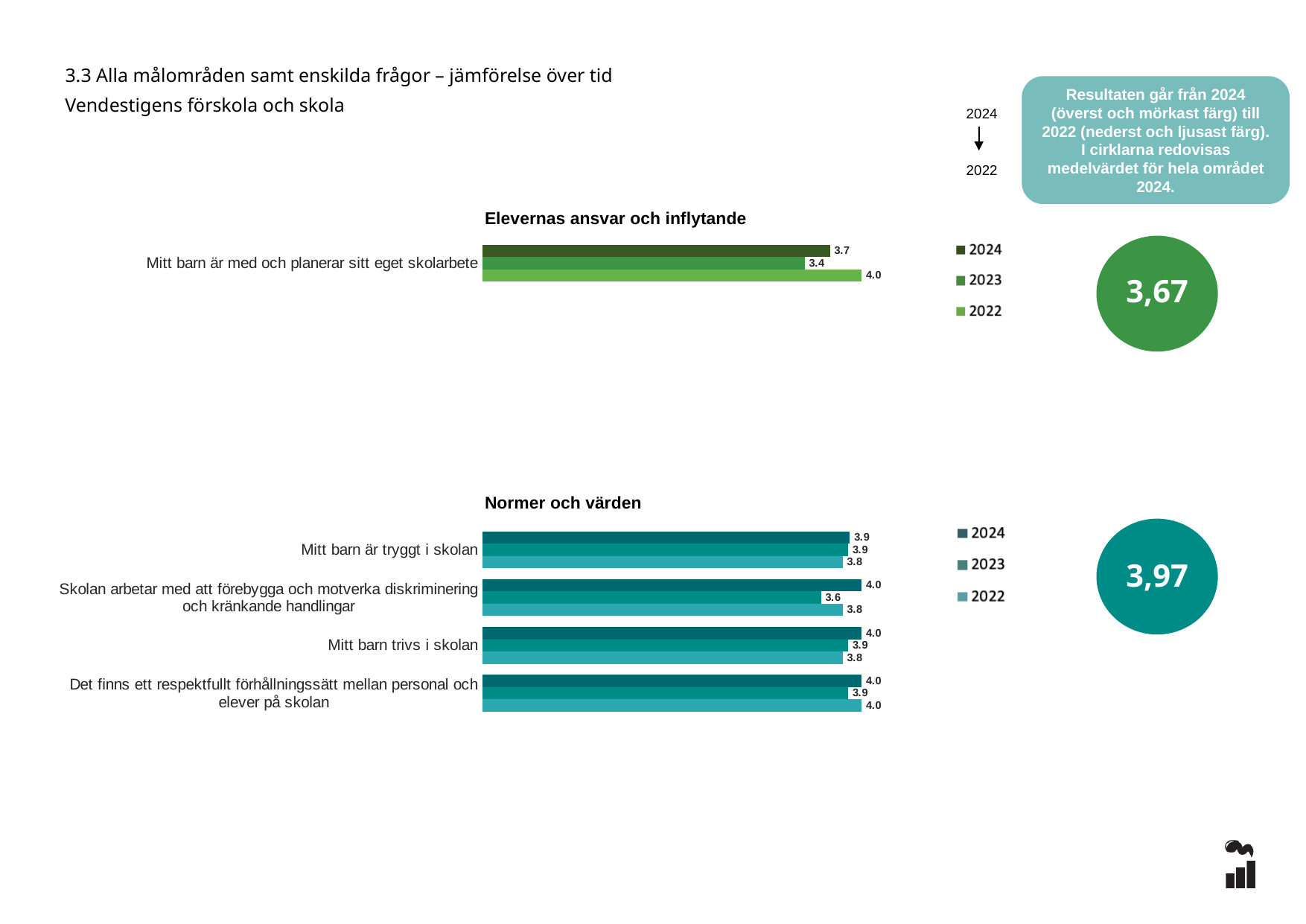
What value is shown in the circle next to the chart 'Normer och värden'? 3,97 In the chart 'Normer och värden', what is the difference between the 2024 and 2022 values for 'Mitt barn trivs i skolan'? 0.2 How many series does the legend of the chart 'Normer och värden' list? 3 In the chart 'Normer och värden', what is the 2022 value for 'Mitt barn trivs i skolan'? 3.8 In the chart 'Elevernas ansvar och inflytande', what is the difference between the 2022 and 2023 values? 0.6 How many categories are shown in the chart 'Normer och värden'? 4 In the chart 'Normer och värden', which is larger for 'Skolan arbetar med att förebygga och motverka diskriminering och kränkande handlingar': the 2024 value or the 2023 value? 2024 In the chart 'Elevernas ansvar och inflytande', what is the 2022 value for 'Mitt barn är med och planerar sitt eget skolarbete'? 4.0 In the chart 'Elevernas ansvar och inflytande', which year has the lowest value for 'Mitt barn är med och planerar sitt eget skolarbete'? 2023 In the chart 'Elevernas ansvar och inflytande', what is the 2024 value for 'Mitt barn är med och planerar sitt eget skolarbete'? 3.7 What kind of chart is 'Normer och värden'? Bar chart In the chart 'Normer och värden', what is the 2023 value for 'Skolan arbetar med att förebygga och motverka diskriminering och kränkande handlingar'? 3.6